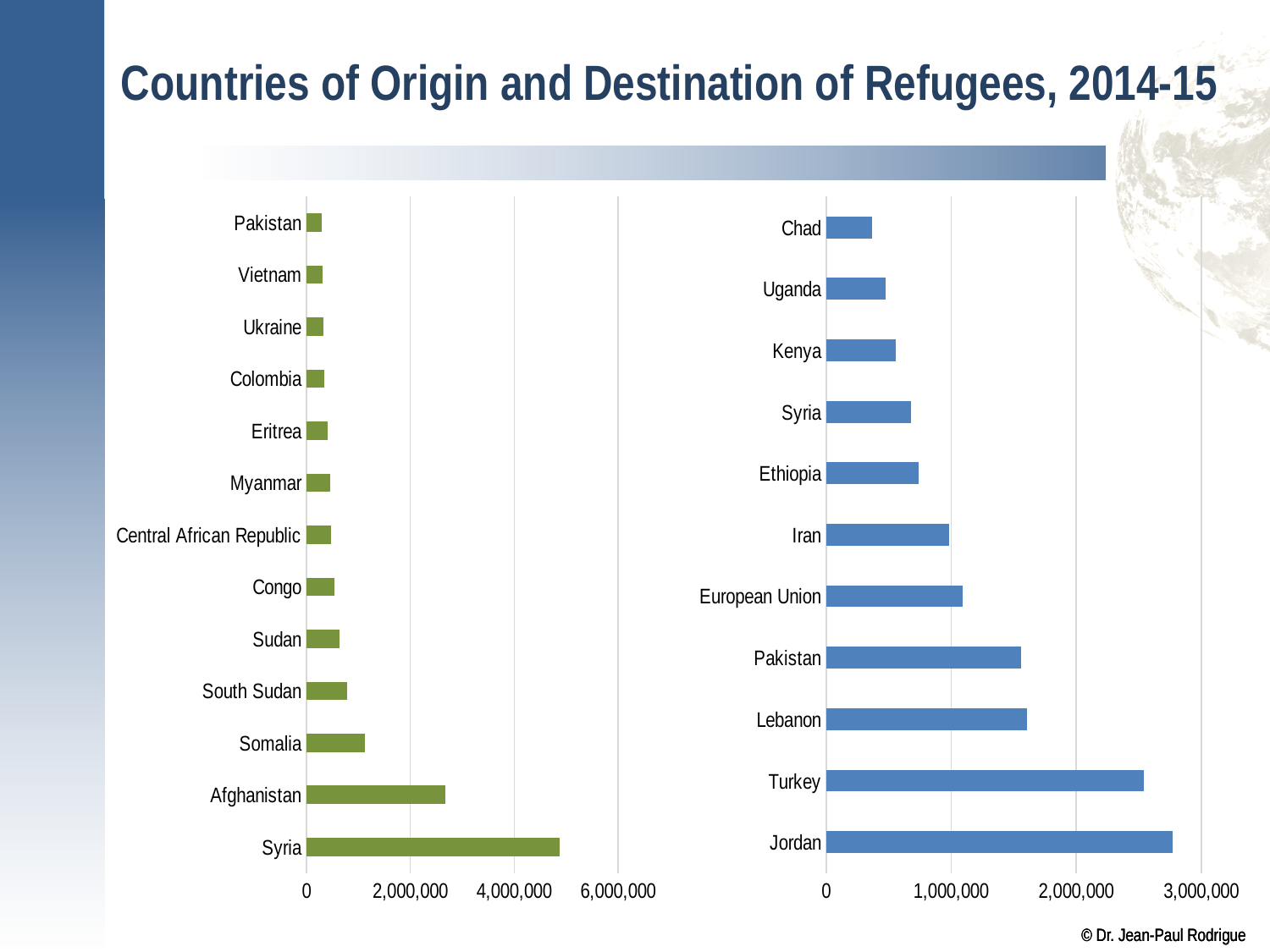
How many categories are shown on the right chart (blue bars)? 11 On the right chart (blue bars), which category has the lowest value? Chad On the left chart (green bars), which country has the highest value? Syria How many categories are shown on the left chart (green bars)? 13 On the right chart (blue bars), is the value for Pakistan greater or less than 1,000,000? greater On the right chart (blue bars), is the value for Turkey greater or less than 2,000,000? greater On the right chart (blue bars), which is larger, the value for Turkey or the value for Lebanon? Turkey On the left chart (green bars), is the value for Afghanistan greater or less than 2,000,000? greater On the right chart (blue bars), which country has the highest value? Jordan